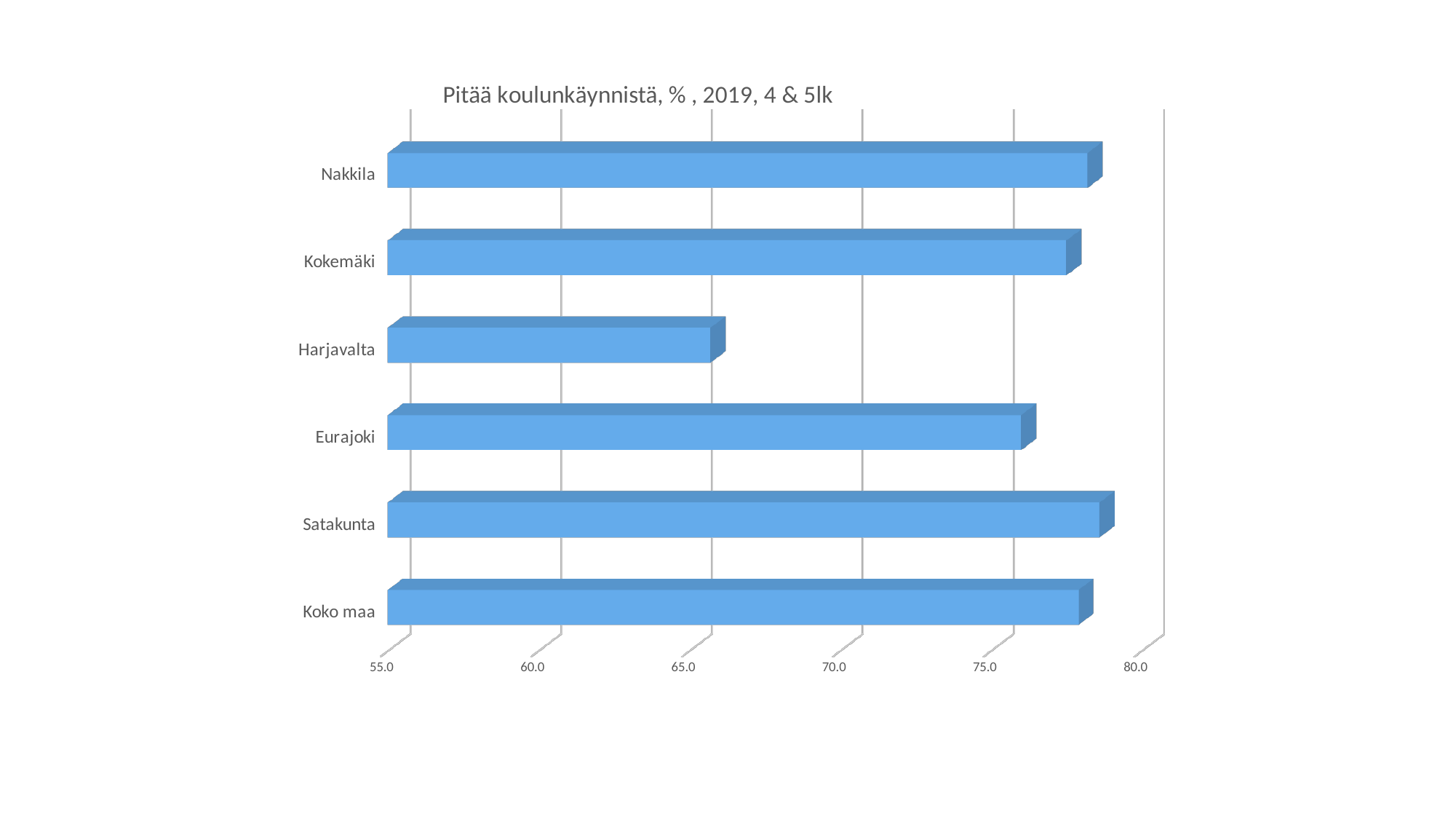
How many categories are plotted in the chart? 6 Is the value for Satakunta greater or less than 80.0? less Is the value for Nakkila greater or less than 75.0? greater Which has the larger value, Eurajoki or Kokemäki? Kokemäki Is the value for Kokemäki greater or less than 75.0? greater Which has the larger value, Harjavalta or Eurajoki? Eurajoki What colour are the bars in the chart? blue Which category has the lowest value? Harjavalta What kind of chart is shown on the slide? bar chart What is the title of the chart? Pitää koulunkäynnistä, % , 2019, 4 & 5lk